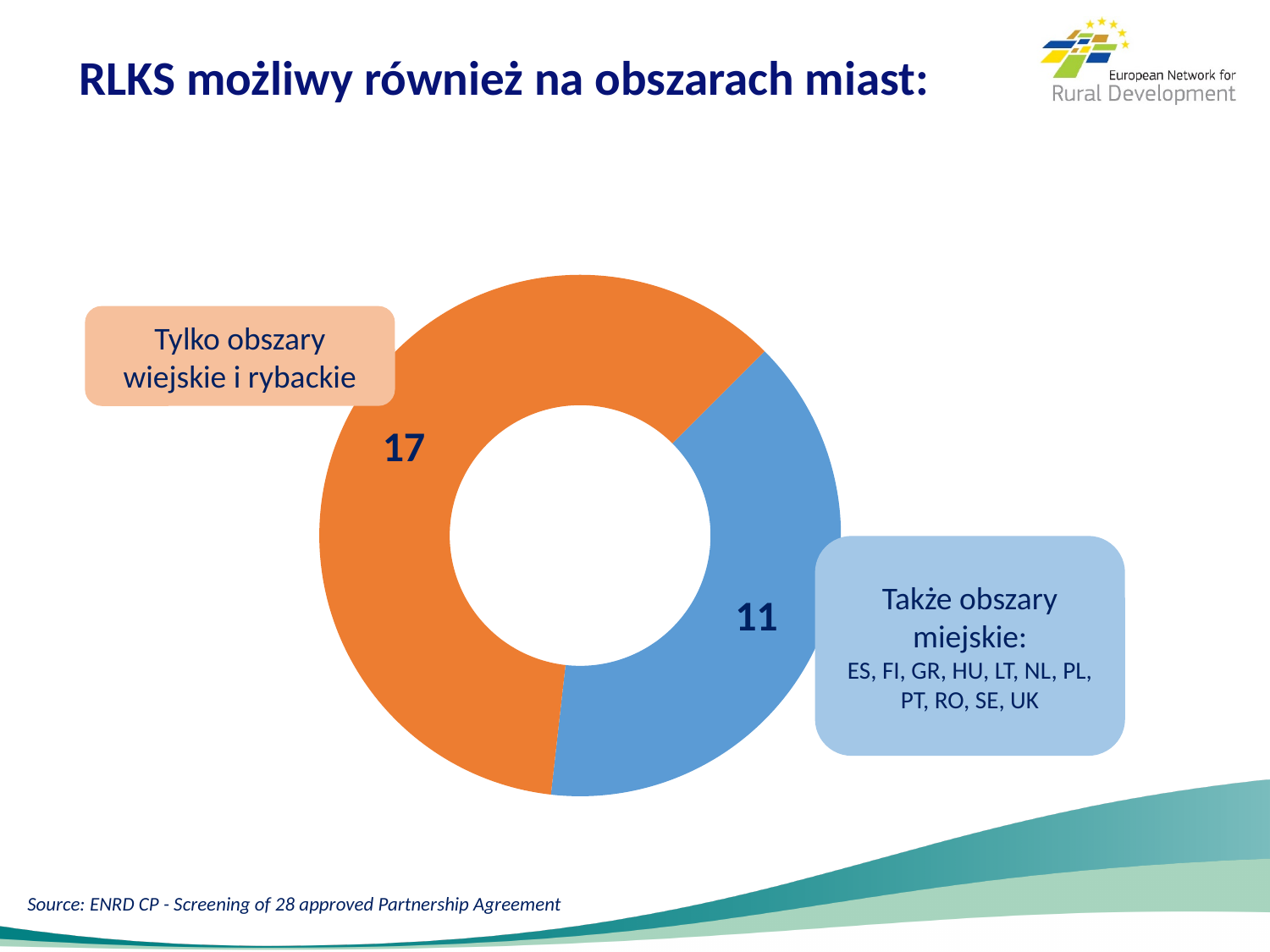
Which countries are listed in the 'Także obszary miejskie' label box? ES, FI, GR, HU, LT, NL, PL, PT, RO, SE, UK What is the total of the two slice values in the chart? 28 What value is shown for the 'Także obszary miejskie' slice? 11 Which slice of the chart is the smallest? Także obszary miejskie What is the difference between the 'Tylko obszary wiejskie i rybackie' value and the 'Także obszary miejskie' value? 6 How many slices does the chart have? 2 Which slice of the chart is the largest? Tylko obszary wiejskie i rybackie What fraction of the total does the 'Także obszary miejskie' slice represent? 11 of 28 What kind of chart is shown on the slide? Pie chart (doughnut) What colour is the 'Tylko obszary wiejskie i rybackie' slice? Orange Which is larger: the value for 'Tylko obszary wiejskie i rybackie' or for 'Także obszary miejskie'? Tylko obszary wiejskie i rybackie What value is shown for the 'Tylko obszary wiejskie i rybackie' slice? 17